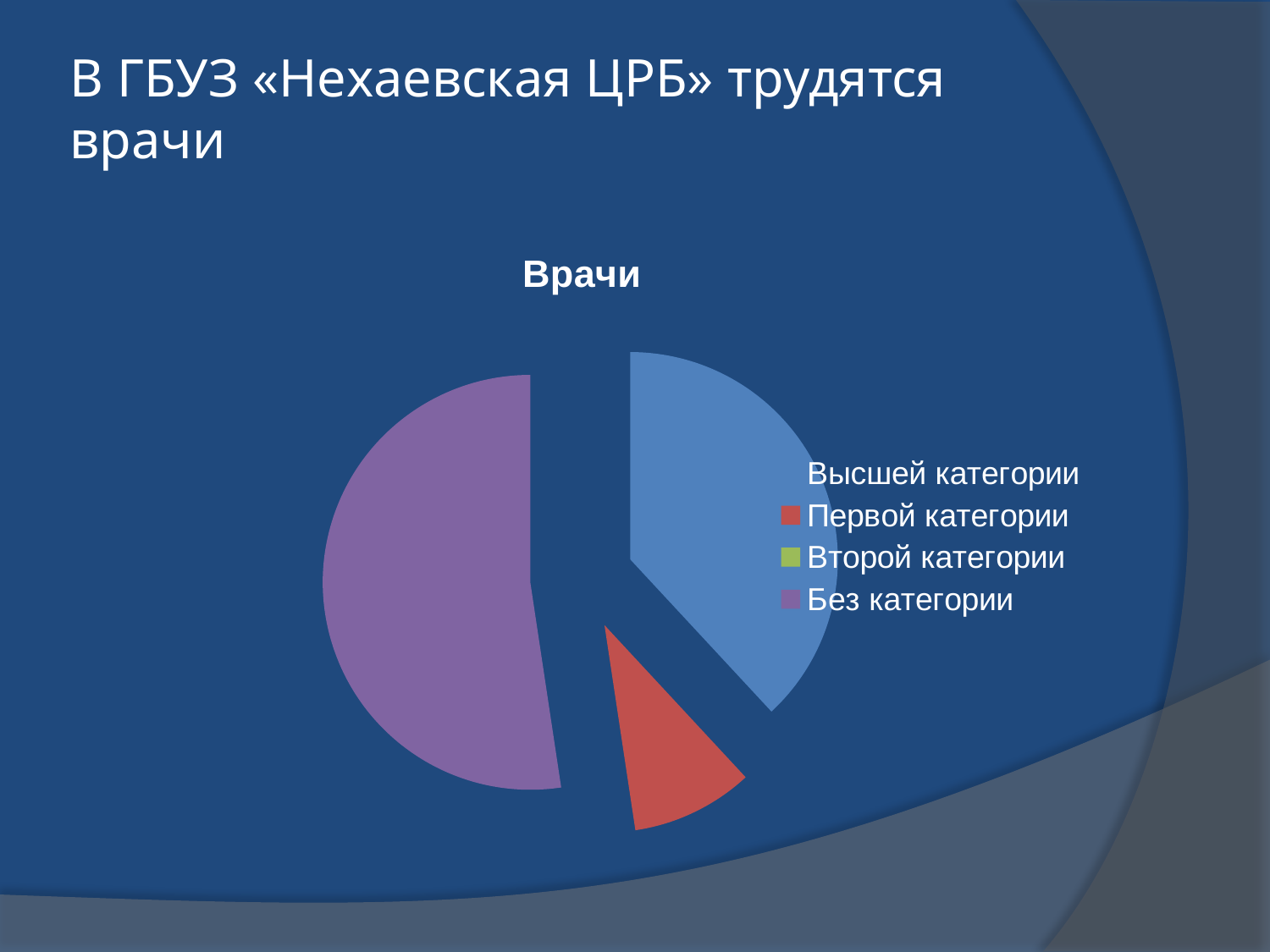
Which slice is larger: Без категории or Высшей категории? Без категории Which colour represents Первой категории in the chart? red What is the title of the chart? Врачи Which slice is larger: Высшей категории or Первой категории? Высшей категории How many categories does the chart's legend list? 4 Which category has the largest slice of the pie? Без категории Which of the visible slices is the smallest: Высшей категории, Первой категории or Без категории? Первой категории What kind of chart is shown on the slide? pie chart Which slice is larger: Без категории or Первой категории? Без категории